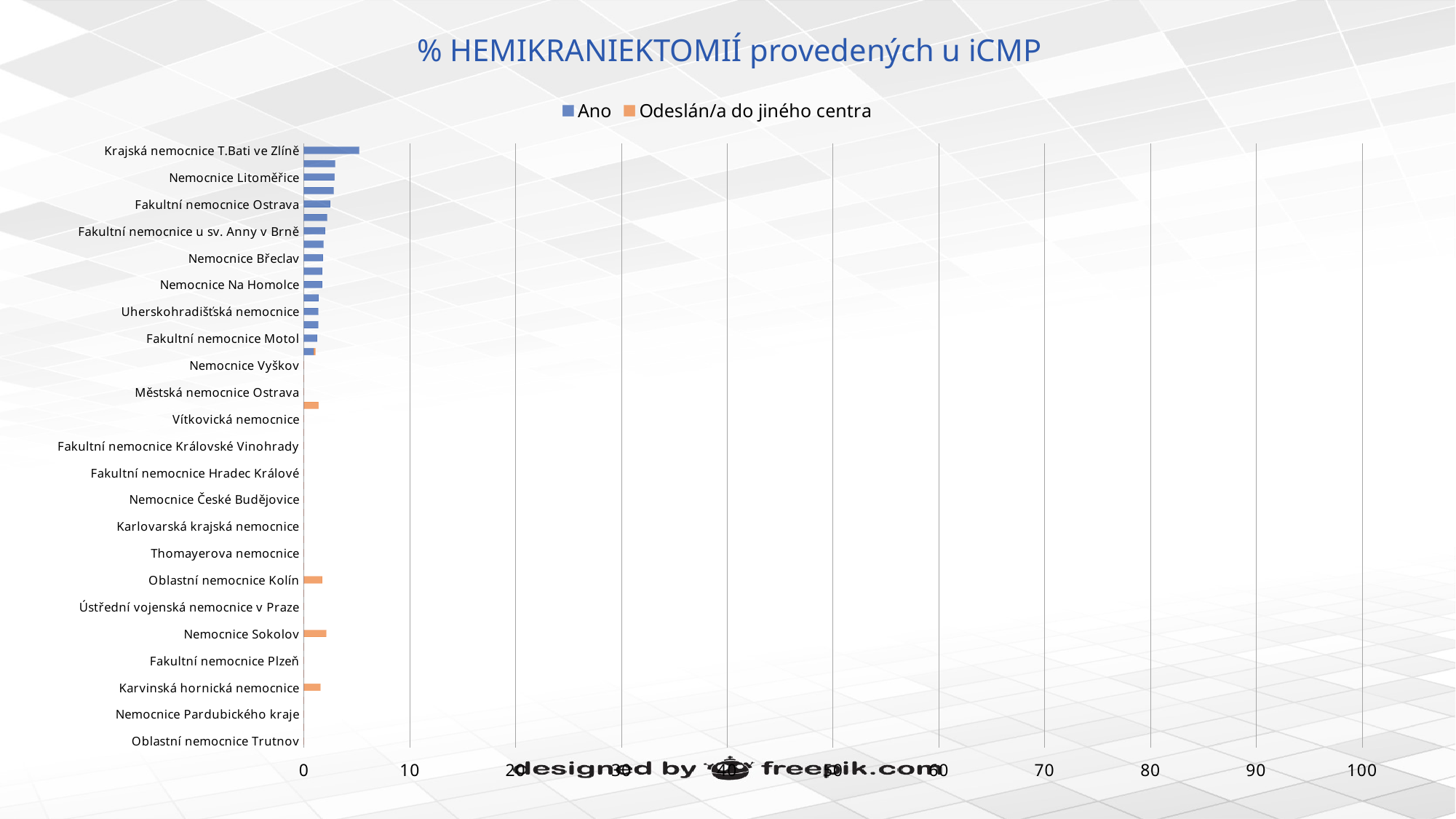
Which is larger, the 'Ano' value for Krajská nemocnice T.Bati ve Zlíně or for Nemocnice Litoměřice? Krajská nemocnice T.Bati ve Zlíně Do the 'Ano' values rise or fall going down the list from Krajská nemocnice T.Bati ve Zlíně to Fakultní nemocnice Motol? fall Is the 'Ano' value for Krajská nemocnice T.Bati ve Zlíně greater or less than 10? less What kind of chart is shown on the slide? bar chart What is the highest value shown on the horizontal axis? 100 Which is larger, the 'Ano' value for Nemocnice Litoměřice or for Fakultní nemocnice Motol? Nemocnice Litoměřice What is the title of the chart? % HEMIKRANIEKTOMIÍ provedených u iCMP Is the 'Odeslán/a do jiného centra' value for Nemocnice Sokolov greater or less than 10? less Which hospital has the highest value for the 'Ano' series? Krajská nemocnice T.Bati ve Zlíně How many series does the legend list? 2 What are the two series named in the legend? Ano; Odeslán/a do jiného centra